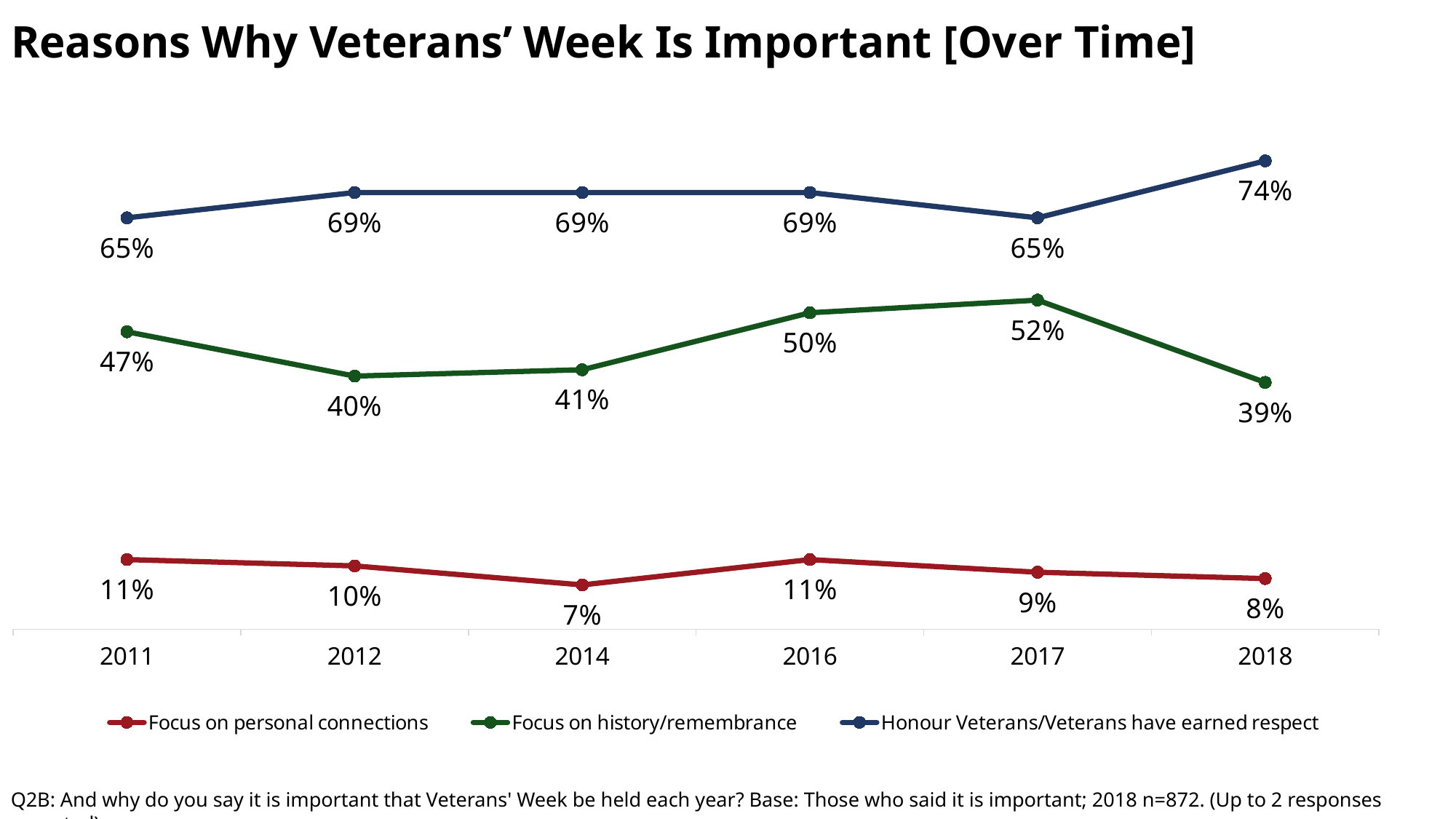
In which year is Focus on history/remembrance at its highest? 2017 What percentage is shown for Focus on personal connections in 2014? 7% What colour is the line for Honour Veterans/Veterans have earned respect? Blue Does Focus on history/remembrance rise or fall from 2017 to 2018? Fall In which year is Focus on personal connections at its lowest? 2014 Which is larger in 2011: Focus on history/remembrance or Focus on personal connections? Focus on history/remembrance What is the difference between Honour Veterans/Veterans have earned respect and Focus on history/remembrance in 2018? 35 percentage points What kind of chart is shown on the slide? Line chart What percentage is shown for Focus on history/remembrance in 2012? 40% What percentage is shown for Honour Veterans/Veterans have earned respect in 2018? 74% How many series does the legend list? 3 How many years are shown on the x axis? 6